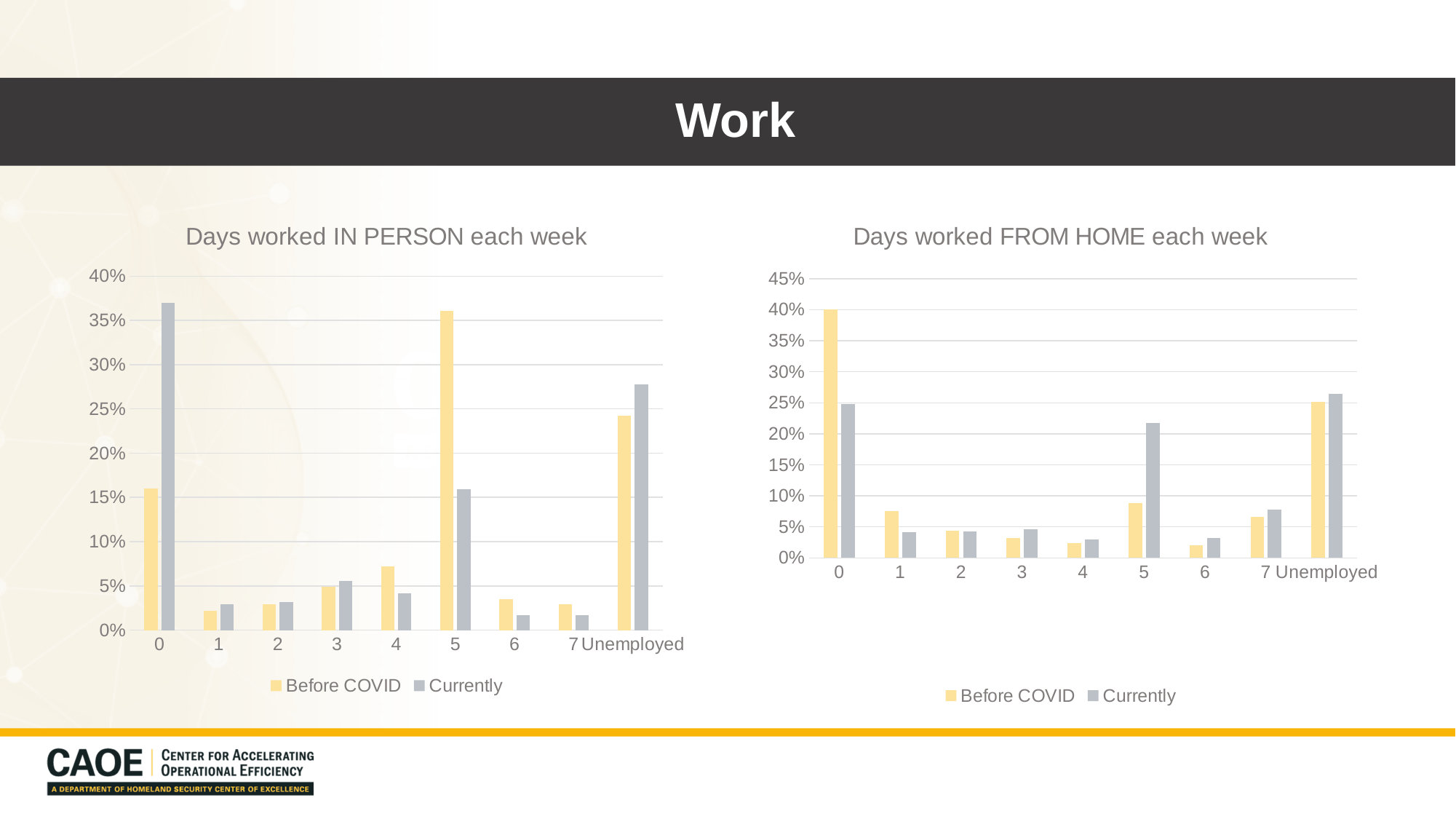
Which colour represents the Currently series in the charts on this slide? gray How many categories are shown on the x axis of "Days worked IN PERSON each week"? 9 In "Days worked IN PERSON each week", is the Before COVID value for 0 greater or less than 20%? less In "Days worked FROM HOME each week", which category has the highest Before COVID value? 0 In "Days worked IN PERSON each week", which category has the highest Before COVID value? 5 In "Days worked IN PERSON each week", which category has the highest Currently value? 0 In "Days worked FROM HOME each week", is the Currently value for 5 greater or less than 15%? greater In "Days worked FROM HOME each week", which is larger for category 0: Before COVID or Currently? Before COVID In "Days worked IN PERSON each week", which is larger for category 5: Before COVID or Currently? Before COVID How many series does the legend of "Days worked FROM HOME each week" list? 2 In "Days worked IN PERSON each week", is the Currently value for 0 greater or less than 35%? greater What kind of chart is "Days worked IN PERSON each week"? bar chart